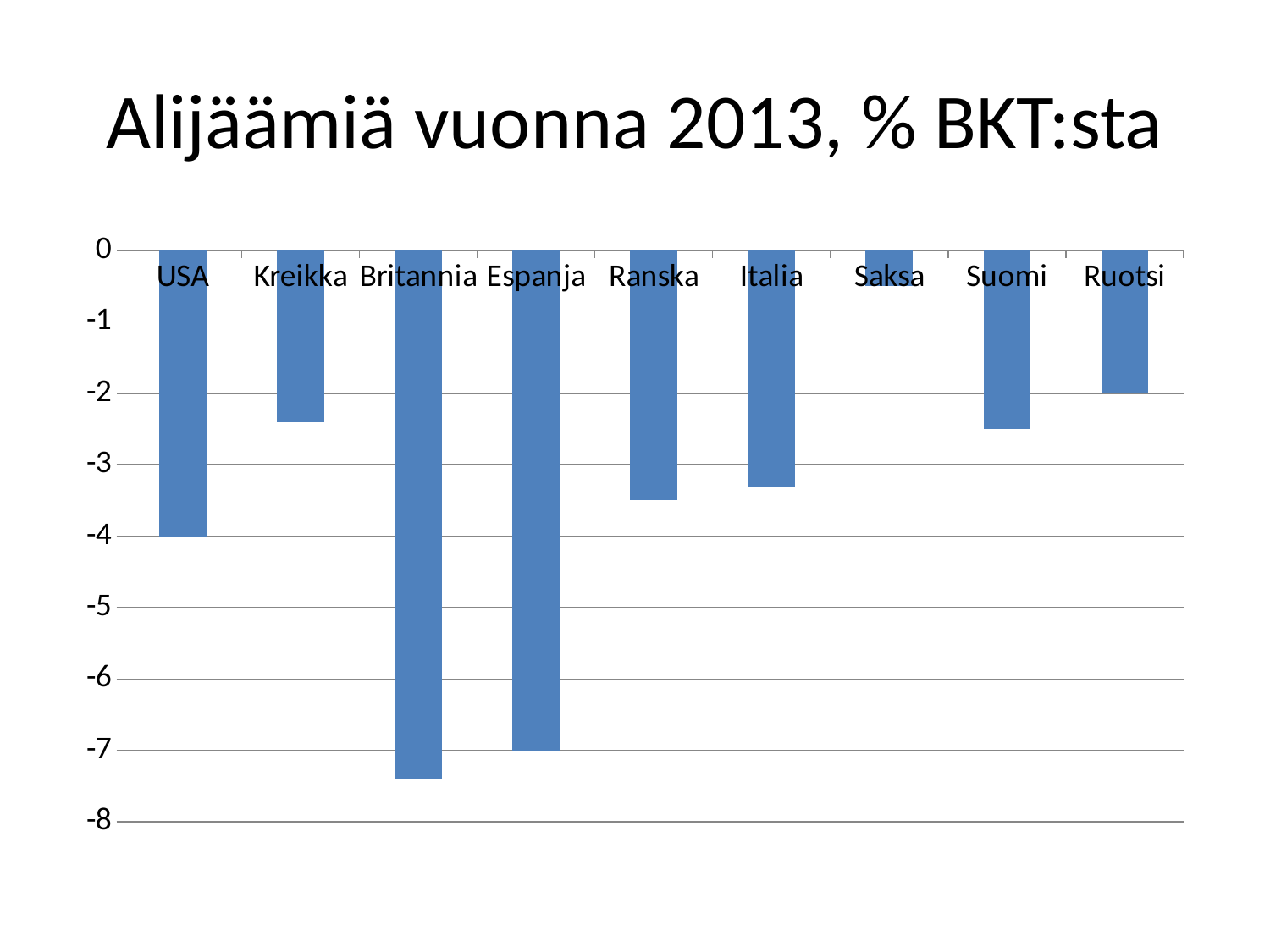
What is the value for Ruotsi? -2 Which country has the lowest (most negative) value? Britannia What is the difference between the values for USA and Espanja? 3 Is the value for Saksa greater or less than -1? greater What is the value for USA? -4 Is the value for Kreikka greater or less than -2? less What is the title of the chart? Alijäämiä vuonna 2013, % BKT:sta Which country has the highest (least negative) value? Saksa Is the value for Britannia greater or less than -7? less How many countries are shown on the chart? 9 Which bar extends further below zero, USA or Kreikka? USA What is the value for Espanja? -7